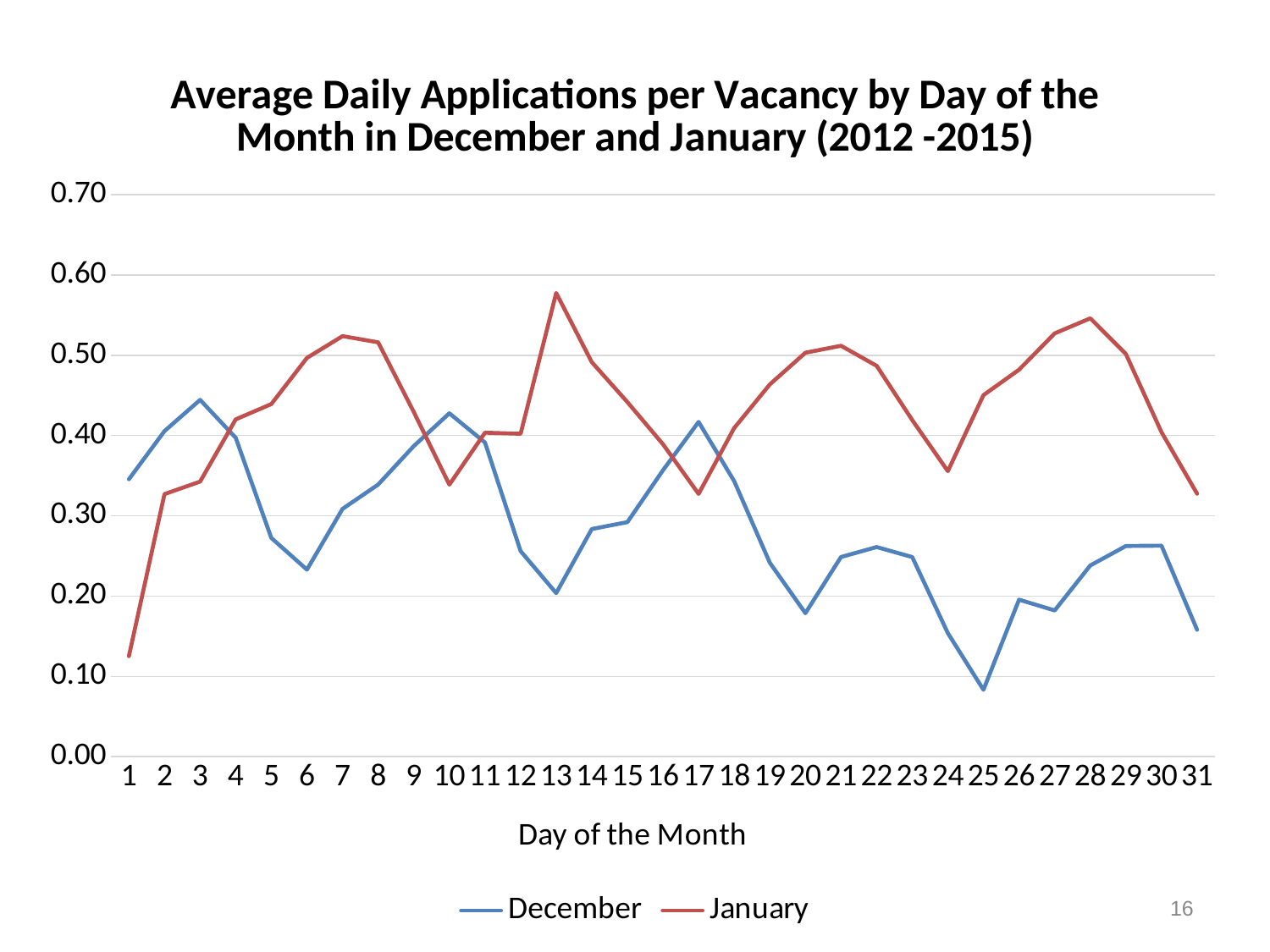
On which day of the month is the January value highest? 13 On which day of the month is the December value lowest? 25 On which day of the month is the January value lowest? 1 Is the January value on day 1 greater or less than 0.20? less Is the January value on day 13 greater or less than 0.50? greater How many series does the legend list? 2 On day 6, which series has the higher value, December or January? January Does the December line rise or fall from day 17 to day 25? fall What kind of chart is shown on the slide? line chart Is the December value on day 25 greater or less than 0.10? less On day 3, which series has the higher value, December or January? December How many days of the month are plotted along the x axis? 31